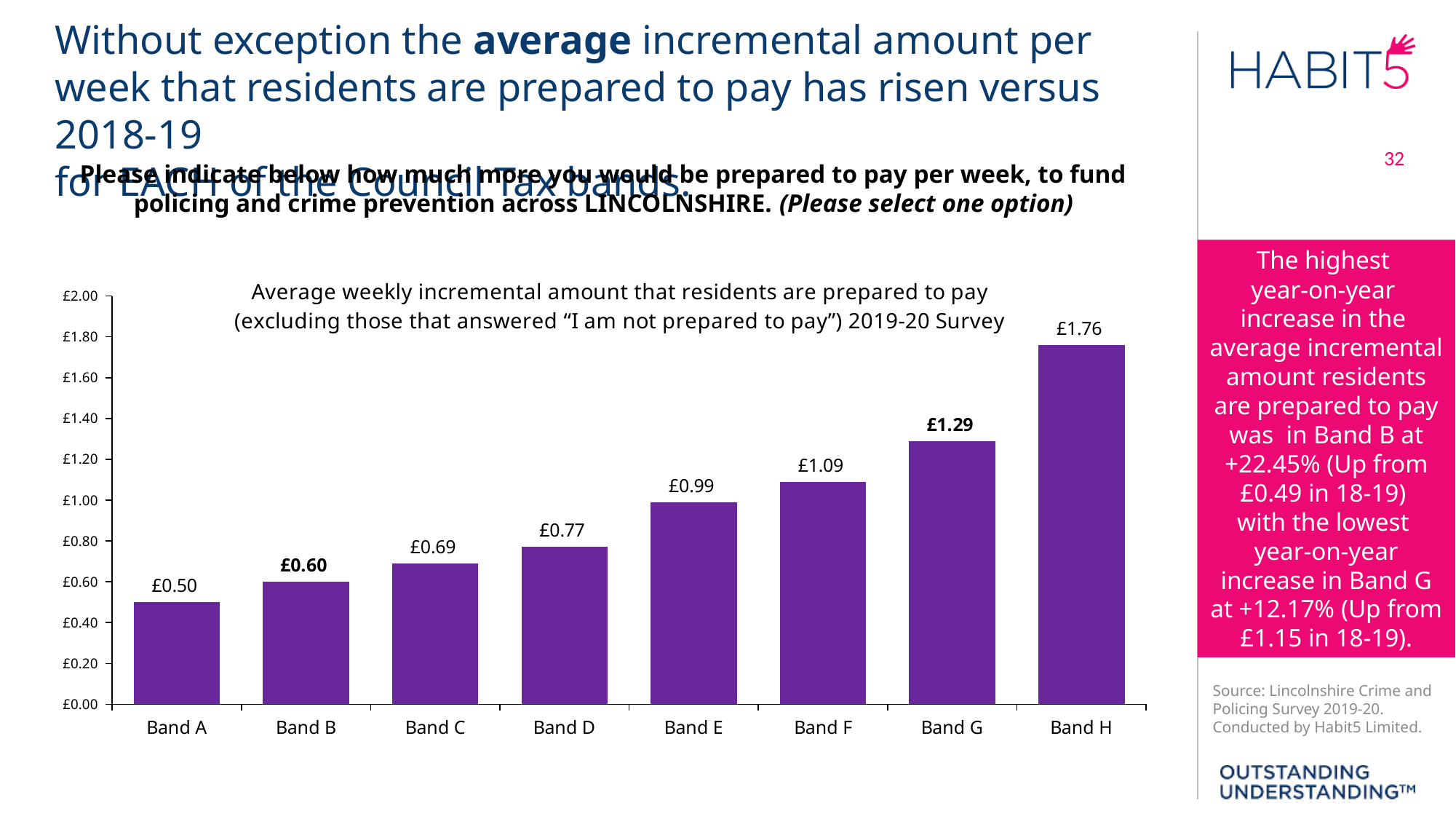
What is the value shown for Band E? £0.99 What is the average weekly incremental amount residents are prepared to pay for Band A? £0.50 What is the difference between the values for Band D and Band C? £0.08 Is the value for Band B greater or less than £0.80? less Which is larger, the value for Band F or the value for Band E? Band F Which Council Tax band has the highest average weekly incremental amount? Band H Do the values rise or fall from Band A to Band H? Rise What kind of chart is used to show the average weekly incremental amounts? Bar chart Which Council Tax band has the lowest average weekly incremental amount? Band A What is the difference between the values for Band H and Band A? £1.26 What is the value shown for Band G? £1.29 How many Council Tax bands are shown on the chart? 8